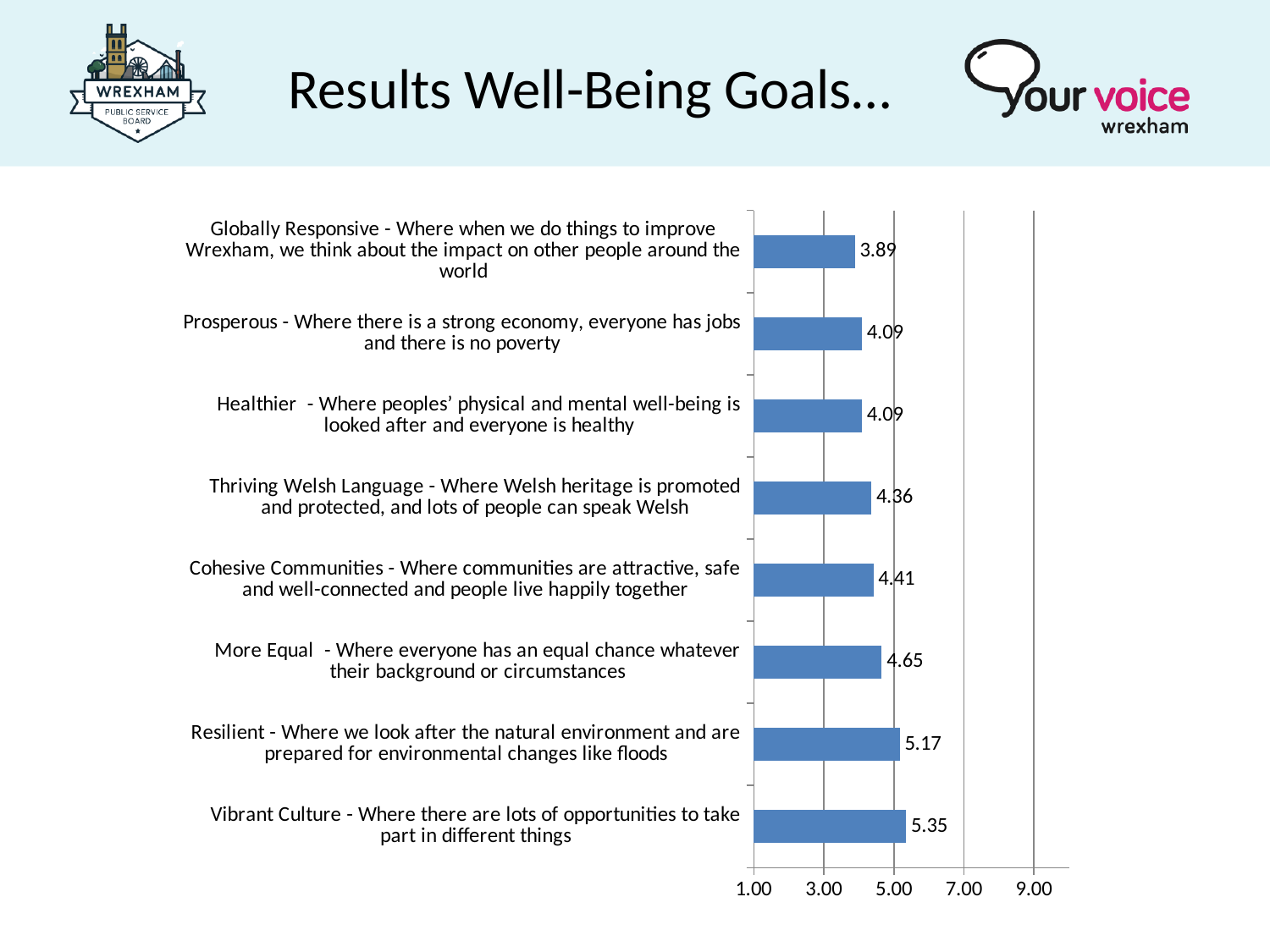
Which has a larger value, Resilient or More Equal? Resilient What is the value for Globally Responsive? 3.89 What is the difference between the values for Vibrant Culture and Globally Responsive? 1.46 What kind of chart is shown on the slide? Bar chart What is the value for Resilient? 5.17 How many well-being goals are shown in the chart? 8 What is the value for Vibrant Culture? 5.35 Is the value for Vibrant Culture greater or less than 5.00? greater Which well-being goal has the lowest value? Globally Responsive What is the difference between the values for More Equal and Cohesive Communities? 0.24 What is the value for Thriving Welsh Language? 4.36 Which well-being goal has the highest value? Vibrant Culture